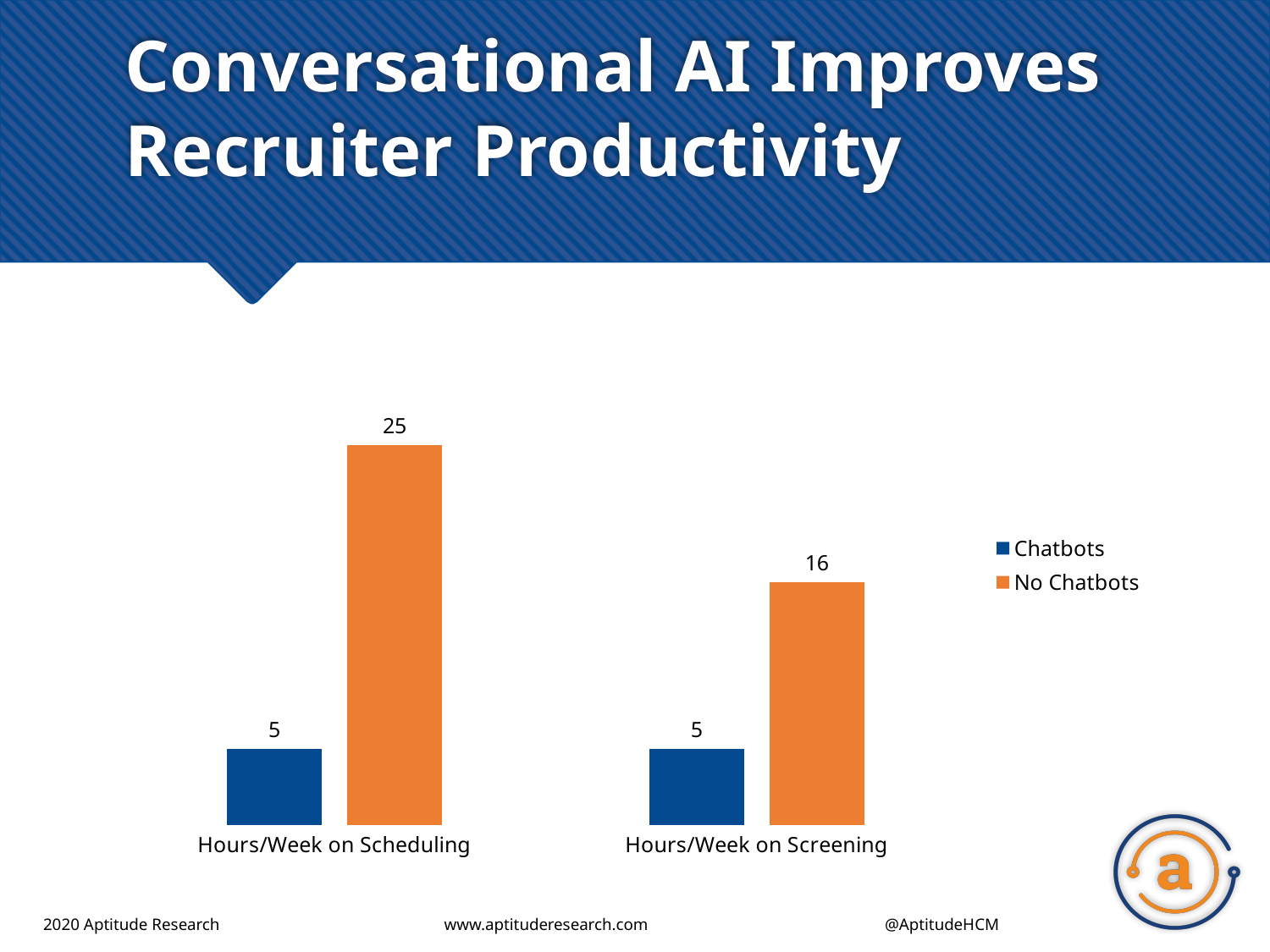
How many series does the legend list? 2 Which series is shown in orange in the legend? No Chatbots Which is larger in the Hours/Week on Screening category: Chatbots or No Chatbots? No Chatbots What is the value for Chatbots in the Hours/Week on Screening category? 5 What kind of chart is shown on the slide? Bar chart What is the value for Chatbots in the Hours/Week on Scheduling category? 5 What is the value for No Chatbots in the Hours/Week on Scheduling category? 25 What is the difference between No Chatbots and Chatbots in the Hours/Week on Scheduling category? 20 Which category has the highest value for the No Chatbots series? Hours/Week on Scheduling What is the difference between No Chatbots and Chatbots in the Hours/Week on Screening category? 11 How many categories are shown on the x axis of the chart? 2 What is the value for No Chatbots in the Hours/Week on Screening category? 16